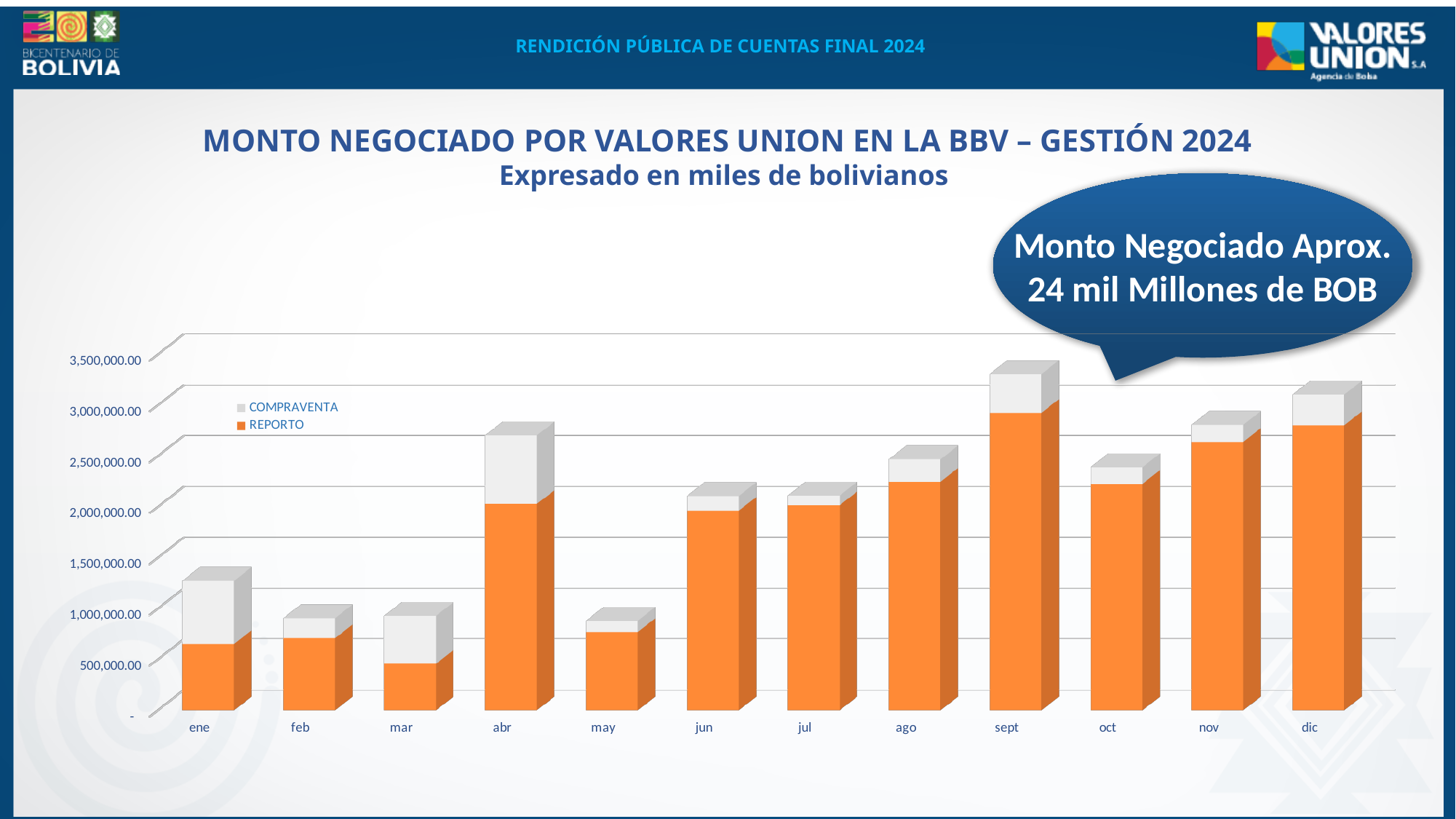
How many months (categories) are plotted on the x axis? 12 What kind of chart is shown on the slide? Stacked bar chart Is the total value for ene greater or less than 1,000,000.00? greater Is the REPORTO value for sept greater or less than 2,500,000.00? greater Which series is shown in orange? REPORTO Which month has the larger total bar, abr or may? abr How many series does the legend list? 2 In what units are the values expressed, according to the subtitle? miles de bolivianos Which month has the highest total bar? sept Is the total value for may greater or less than 1,000,000.00? less Do the total bars generally rise or fall from jun to sept? rise